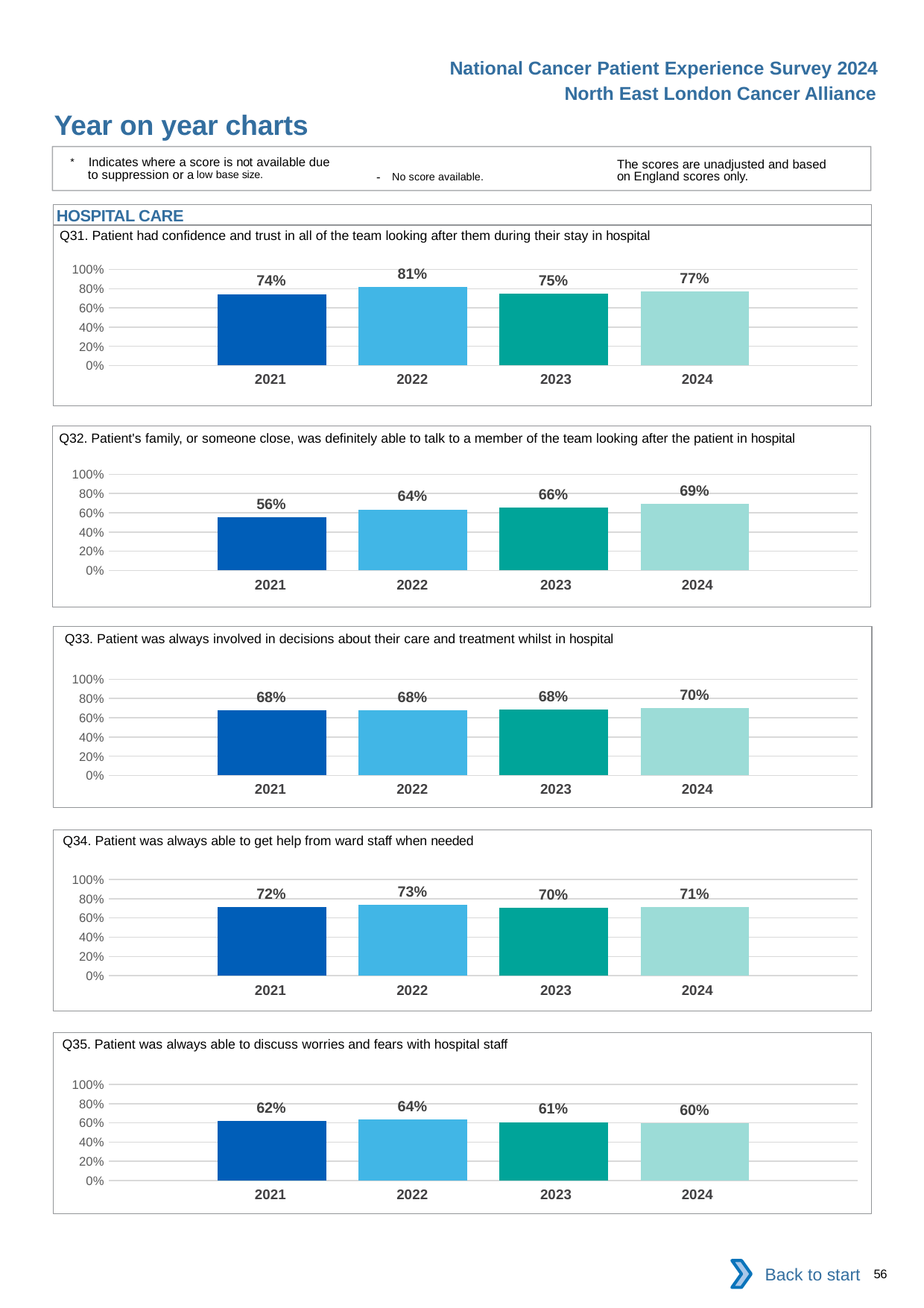
How many years are shown on the x axis of the Q31 chart? 4 In the Q32 chart, do the values rise or fall from 2021 to 2024? rise In the Q35 chart, which is larger, the value for 2022 or the value for 2024? 2022 In the Q33 chart, what is the value for 2024? 70% How many charts are shown on the slide? 5 In the Q34 chart, which year has the highest value? 2022 In the Q32 chart, which year has the lowest value? 2021 In the Q31 chart, what is the value for 2022? 81% In the Q35 chart, what is the value for 2023? 61% In the Q32 chart, what is the difference between the 2024 and 2021 values? 13% In the Q31 chart, what is the difference between the 2022 and 2023 values? 6% What kind of chart is the Q34 chart? bar chart